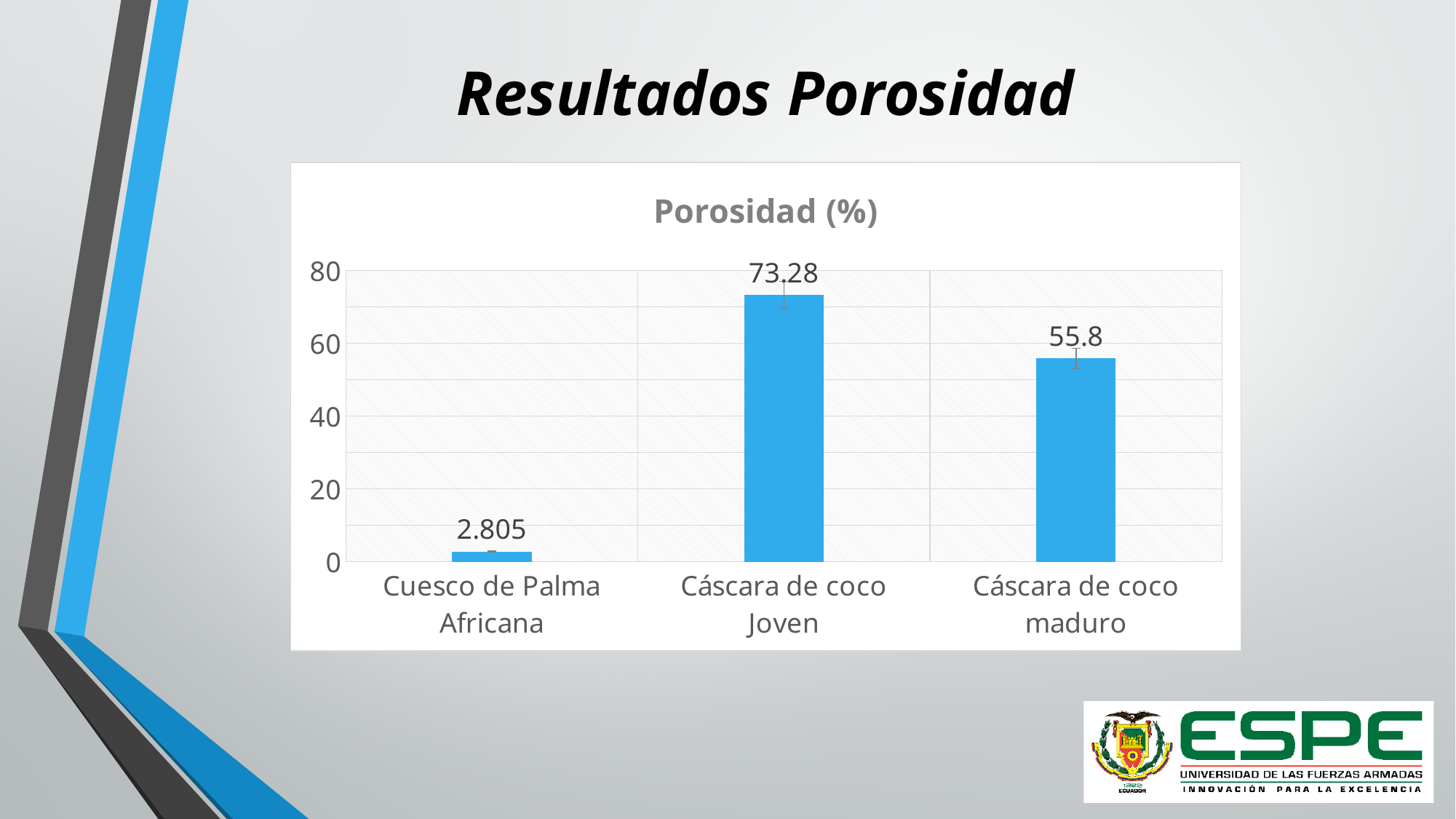
What is the title of the chart? Porosidad (%) What is the highest value shown on the vertical axis? 80 What is the difference in porosity between Cáscara de coco Joven and Cáscara de coco maduro? 17.48 How many categories are shown in the chart? 3 Which has a larger porosity value, Cáscara de coco maduro or Cuesco de Palma Africana? Cáscara de coco maduro What is the porosity value for Cáscara de coco Joven? 73.28 What is the porosity value for Cuesco de Palma Africana? 2.805 Which category has the lowest porosity? Cuesco de Palma Africana What type of chart is shown on the slide? Bar chart Is the porosity value for Cáscara de coco maduro greater or less than 40? greater What is the porosity value for Cáscara de coco maduro? 55.8 Which category has the highest porosity? Cáscara de coco Joven